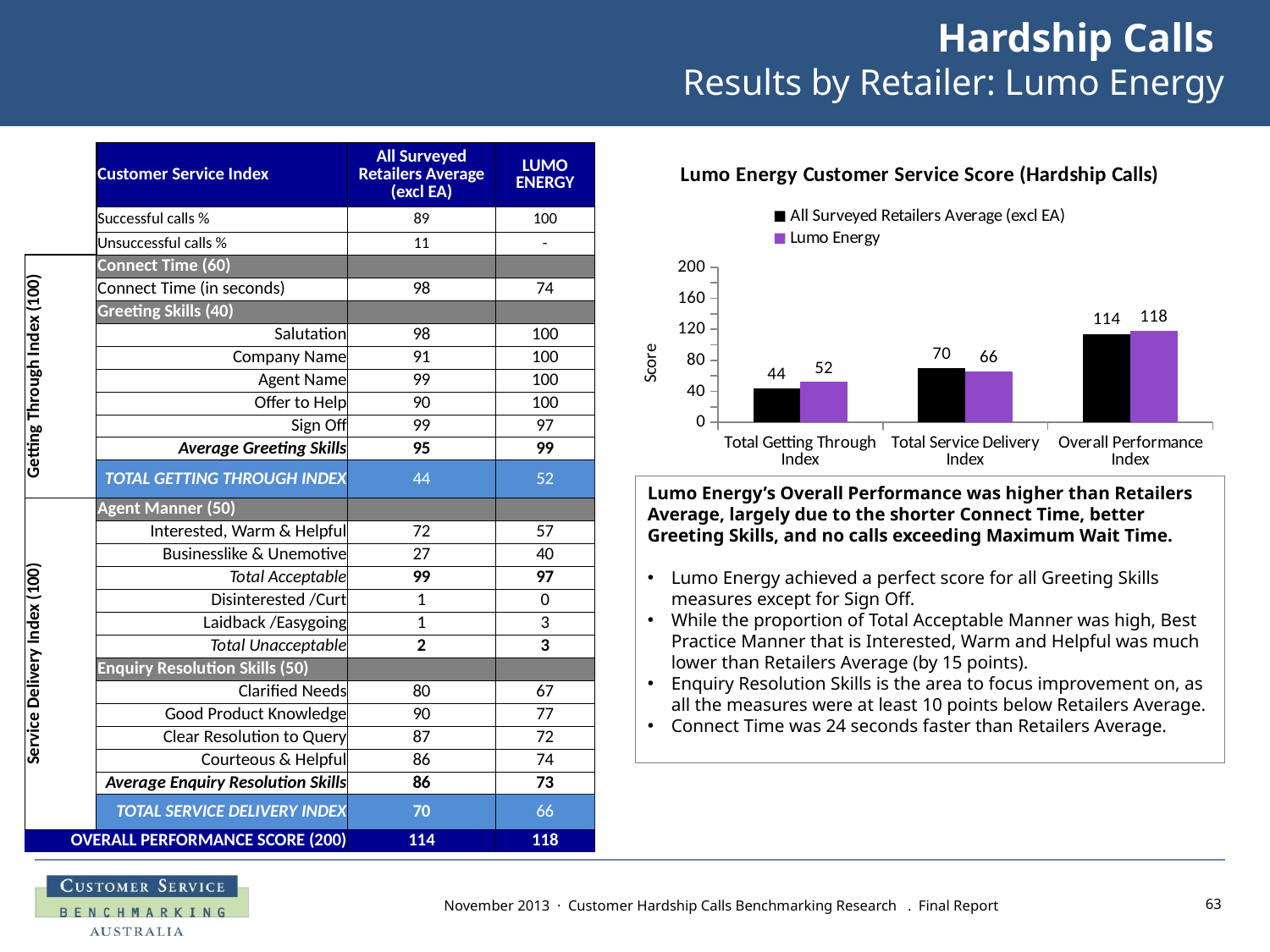
What is the All Surveyed Retailers Average (excl EA) value for the Total Service Delivery Index in the chart? 70 Which category has the highest Lumo Energy value in the chart? Overall Performance Index Which category has the lowest All Surveyed Retailers Average (excl EA) value in the chart? Total Getting Through Index For the Overall Performance Index, which is larger: the All Surveyed Retailers Average or Lumo Energy? Lumo Energy What is the Lumo Energy value for the Overall Performance Index in the chart? 118 How many series does the chart legend list? 2 What is the difference between the Lumo Energy and All Surveyed Retailers Average values for the Total Getting Through Index? 8 Is the Lumo Energy value for the Overall Performance Index greater or less than 80? greater What type of chart is shown on the slide? Bar chart What is the difference between the All Surveyed Retailers Average and Lumo Energy values for the Total Service Delivery Index? 4 How many categories are shown on the x axis of the chart? 3 What is the Lumo Energy value for the Total Getting Through Index in the chart? 52